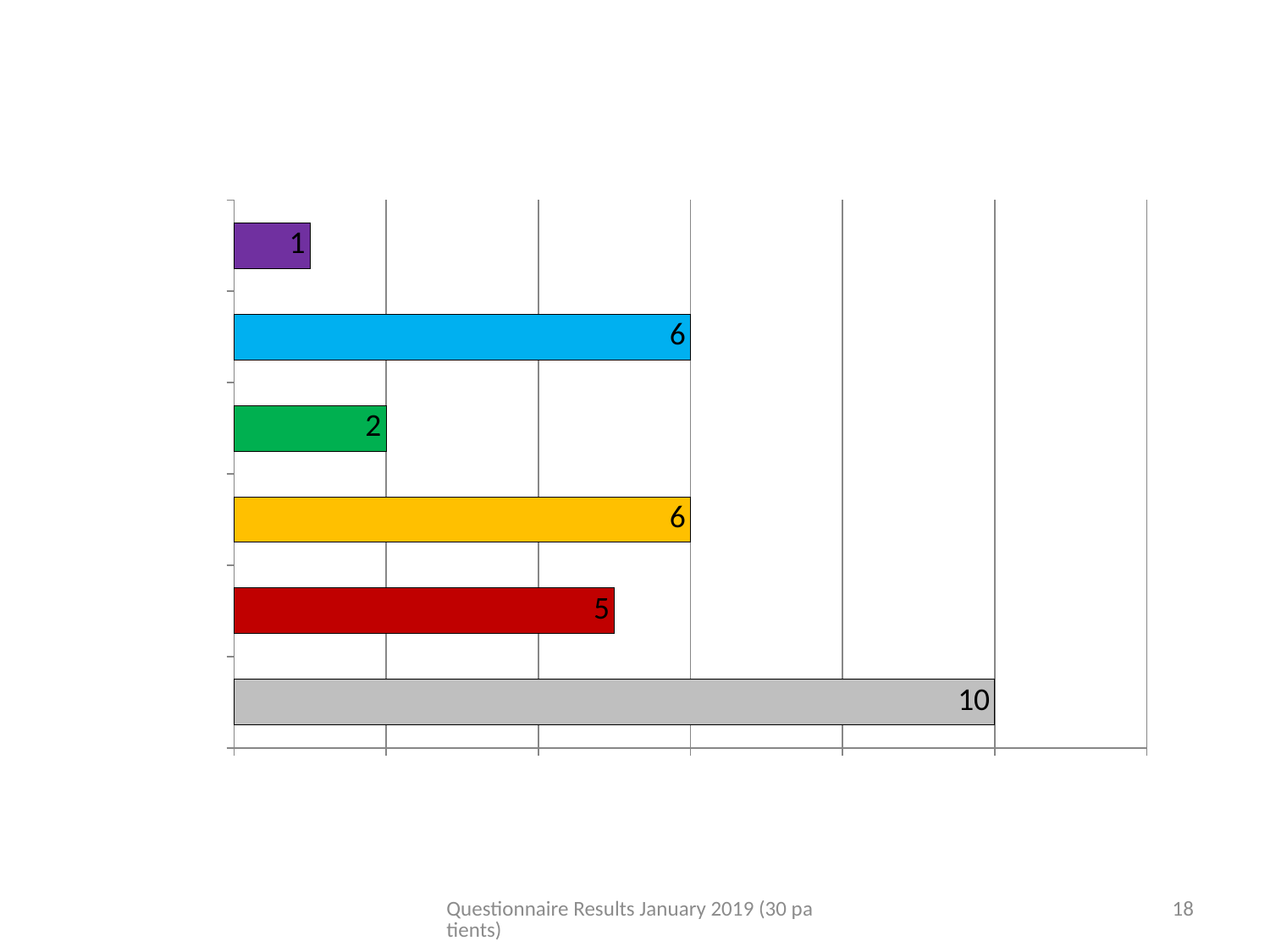
Which bar has the highest value? the grey bar (10) Which bar has the lowest value? the purple bar (1) What is the value of the blue bar? 6 What is the value of the purple bar at the top of the chart? 1 What kind of chart is shown on the slide? bar chart What is the value of the red bar? 5 What is the value of the grey bar at the bottom of the chart? 10 What is the total of all the bar values in the chart? 30 What is the difference between the grey bar and the red bar? 5 Which is larger, the yellow bar or the green bar? the yellow bar How many bars are plotted in the chart? 6 What is the value of the green bar? 2